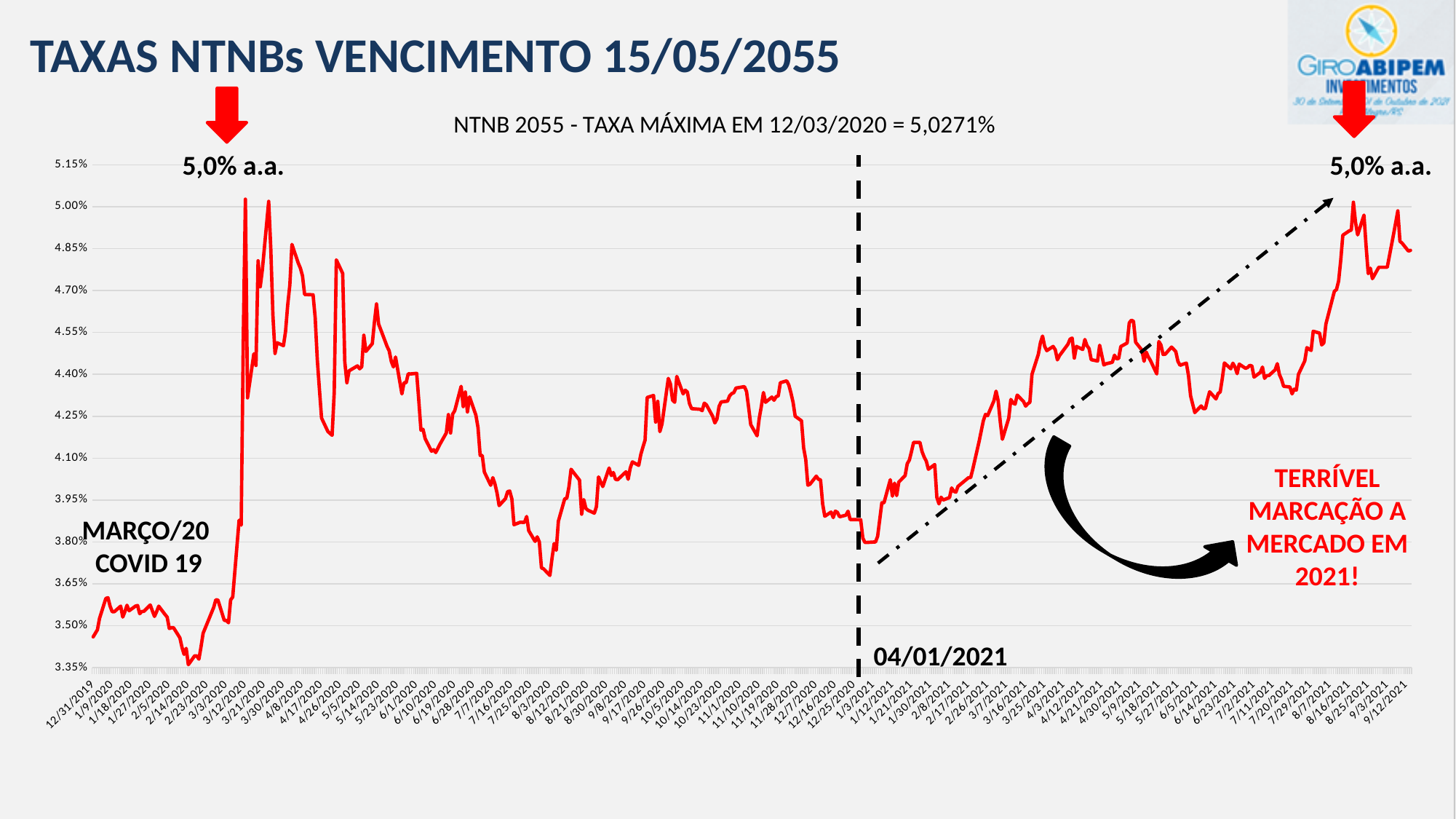
Between 3/12/2020 and 8/3/2020, does the rate generally rise or fall? fall According to the chart title, on what date did the NTNB 2055 rate reach its maximum? 12/03/2020 Between 04/01/2021 and 9/12/2021, does the rate generally rise or fall? rise Is the value around 8/3/2020 greater or less than 3.95%? less Is the value around 4/8/2020 greater or less than 4.25%? greater According to the chart title, what was the maximum rate of the NTNB 2055? 5,0271% What is the lowest value shown on the y axis? 3.35% What kind of chart is shown on the slide? line chart Is the value at 9/12/2021 greater or less than 4.55%? greater What date is marked by the dashed vertical line on the chart? 04/01/2021 What is the title of the chart? NTNB 2055 - TAXA MÁXIMA EM 12/03/2020 = 5,0271%